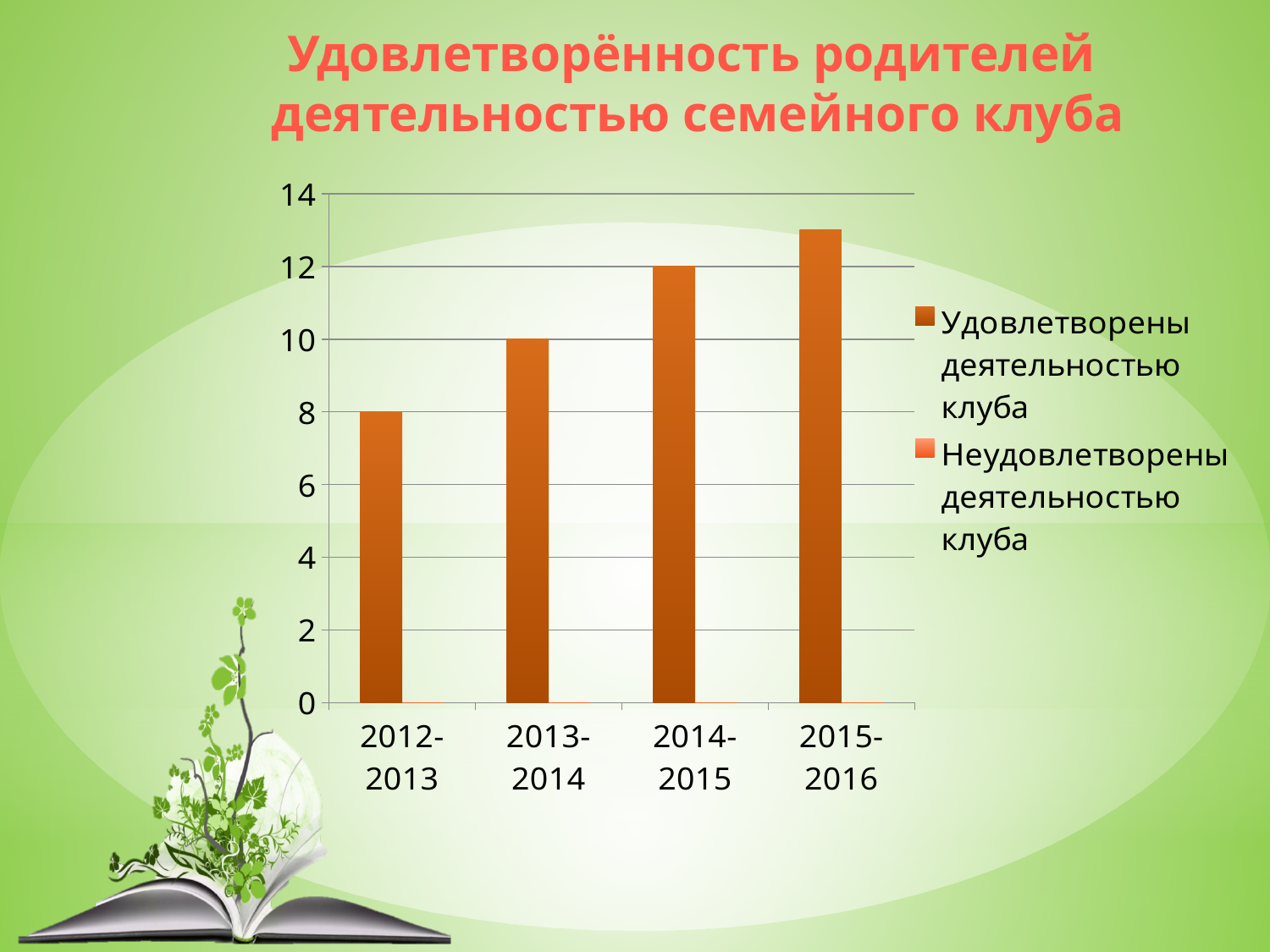
How many school-year categories are shown on the x axis? 4 Which year has the highest value for 'Удовлетворены деятельностью клуба'? 2015-2016 What is the value for 'Удовлетворены деятельностью клуба' in 2013-2014? 10 What kind of chart is shown on the slide? bar chart What is the value for 'Удовлетворены деятельностью клуба' in 2012-2013? 8 Do the 'Удовлетворены деятельностью клуба' values rise or fall from 2012-2013 to 2015-2016? rise Which year has the lowest value for 'Удовлетворены деятельностью клуба'? 2012-2013 How many series does the legend list? 2 What is the difference between the 'Удовлетворены деятельностью клуба' values for 2014-2015 and 2012-2013? 4 What is the value for 'Удовлетворены деятельностью клуба' in 2014-2015? 12 Is the value for 'Удовлетворены деятельностью клуба' in 2015-2016 greater or less than 12? greater Which year has the larger 'Удовлетворены деятельностью клуба' value, 2013-2014 or 2014-2015? 2014-2015